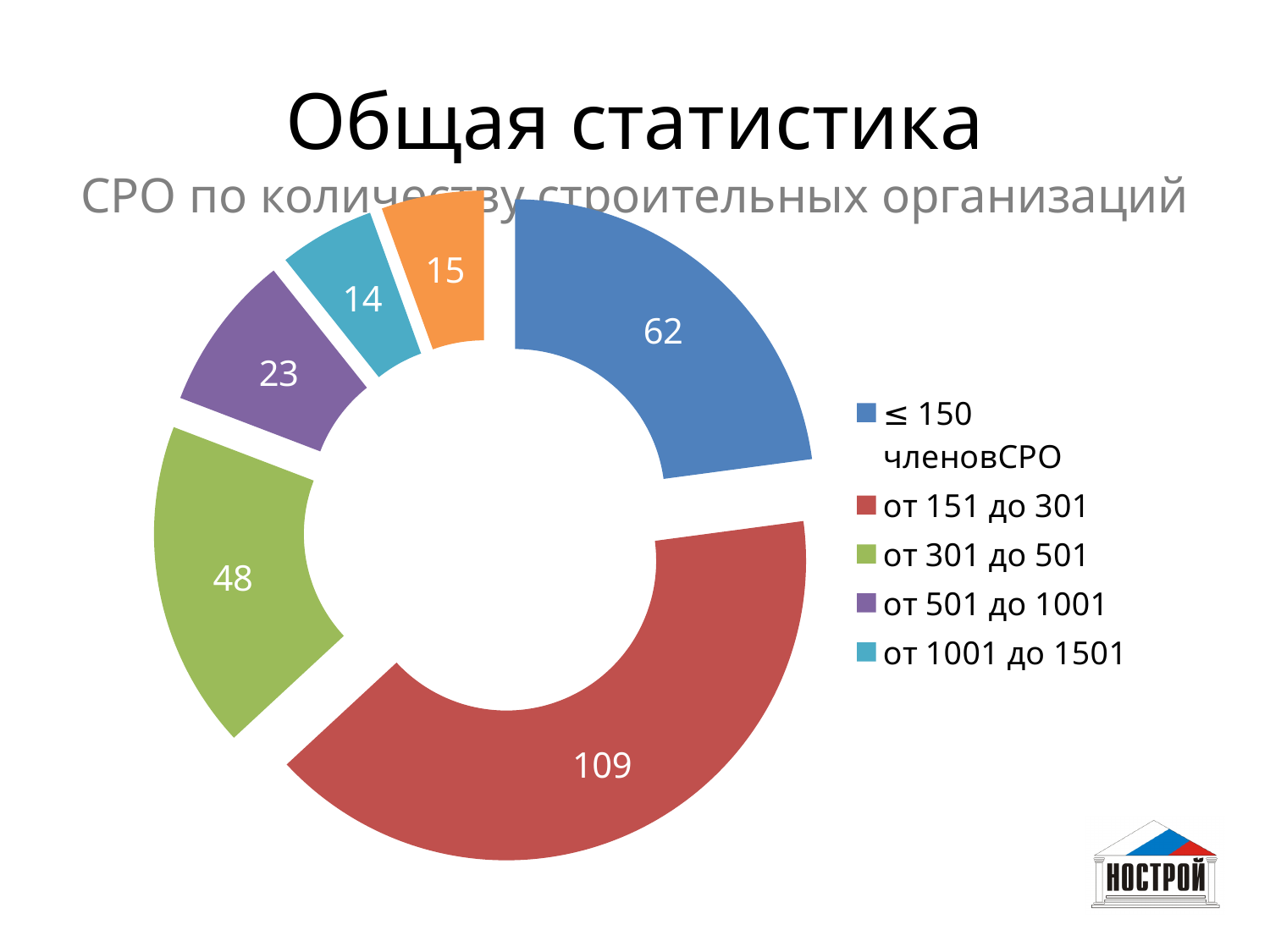
What kind of chart is shown on the slide? Doughnut (pie) chart What value is shown for the "≤ 150 членов СРО" slice? 62 What is the total of all the slice values shown in the chart? 271 Which category has the smallest slice in the chart? от 1001 до 1501 How many slices does the chart have? 6 What is the difference between the "от 151 до 301" slice and the "≤ 150 членов СРО" slice? 47 What value is shown for the "от 301 до 501" slice? 48 What value is shown for the "от 151 до 301" slice? 109 Which category has the largest slice in the chart? от 151 до 301 What value is shown for the "от 501 до 1001" slice? 23 Which is larger: the "от 301 до 501" slice or the "от 501 до 1001" slice? от 301 до 501 What value is shown for the "от 1001 до 1501" slice? 14